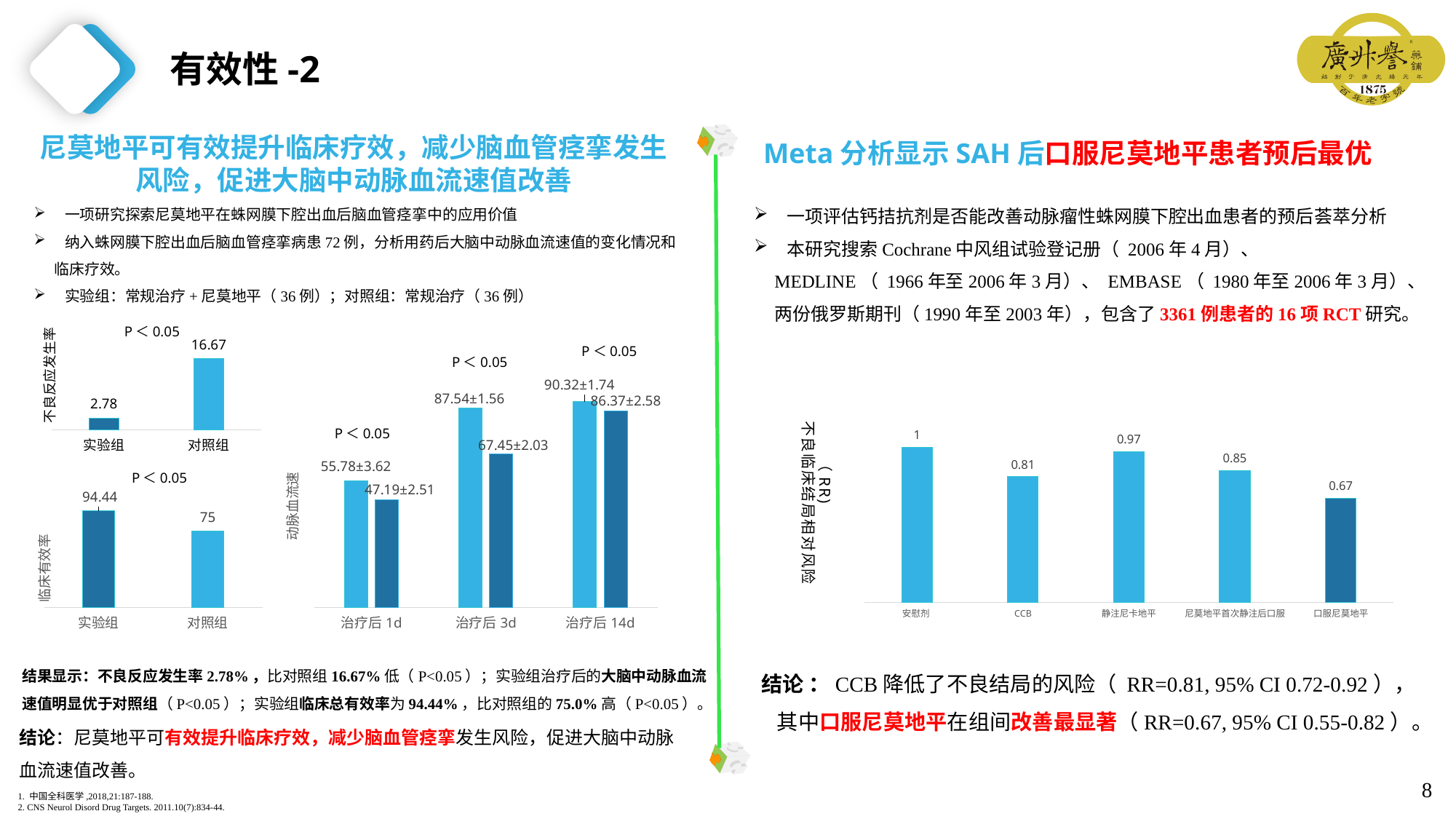
In the 动脉血流速 chart (middle), how many time-point categories are shown on the x axis? 3 In the 不良临床结局相对风险 (RR) chart on the right, which category has the lowest value? 口服尼莫地平 In the 不良临床结局相对风险 (RR) chart on the right, what is the value for 静注尼卡地平? 0.97 In the 不良反应发生率 chart (top left), what is the value for 对照组? 16.67 In the 临床有效率 chart (bottom left), which group has the higher value? 实验组 In the 临床有效率 chart (bottom left), what is the difference between 实验组 and 对照组? 19.44 In the 动脉血流速 chart (middle), what is the value of the darker blue bar at 治疗后 1d? 47.19±2.51 In the 不良反应发生率 chart (top left), what is the value for 实验组? 2.78 What type of chart is the 不良临床结局相对风险 (RR) chart on the right? bar chart In the 不良临床结局相对风险 (RR) chart on the right, how many categories are shown? 5 In the 动脉血流速 chart (middle), do the lighter blue bars rise or fall from 治疗后 1d to 治疗后 14d? rise In the 动脉血流速 chart (middle), what is the value of the lighter blue bar at 治疗后 3d? 87.54±1.56